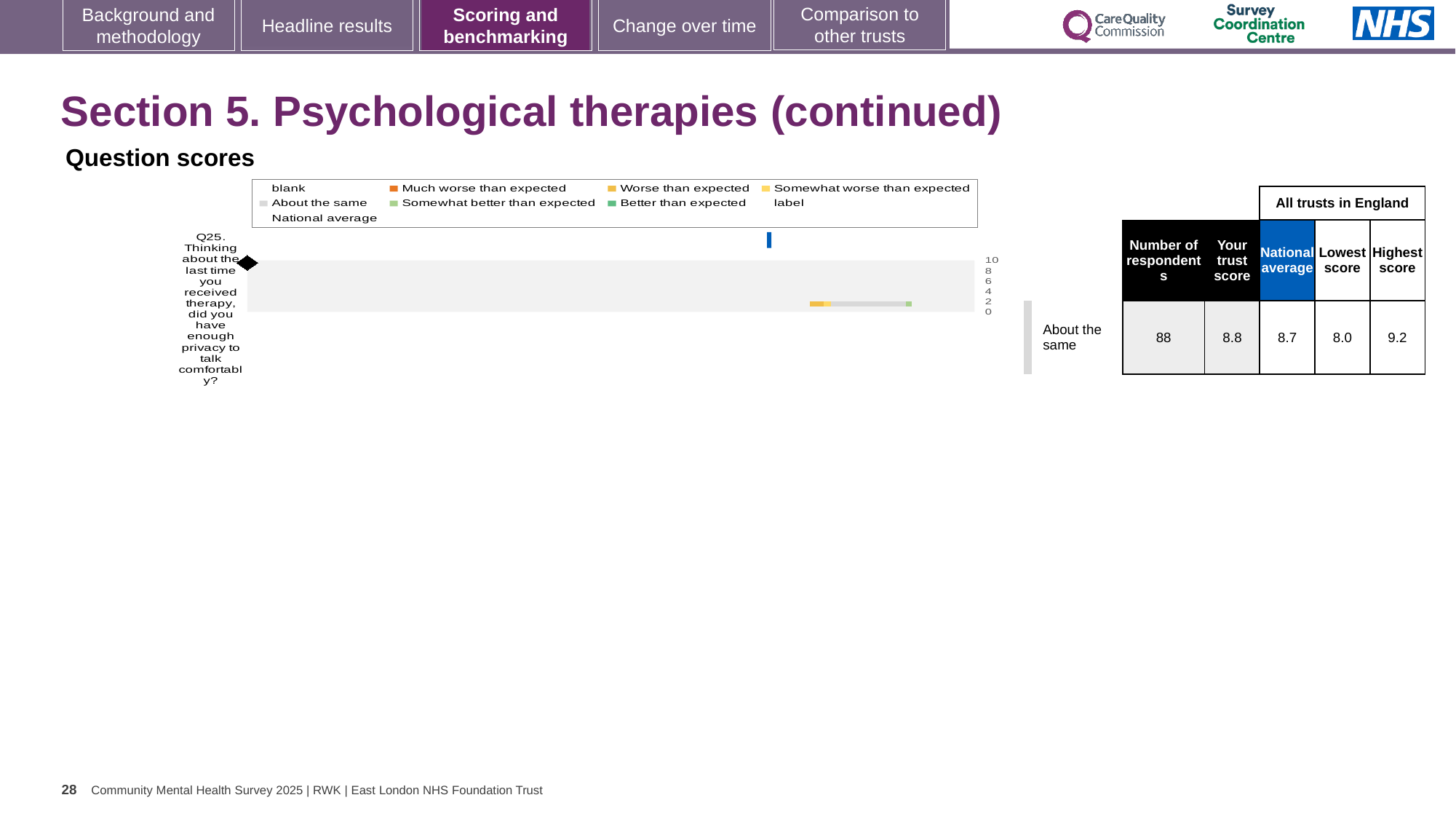
What is the difference between the highest and lowest trust scores for Q25? 1.2 What is the trust's score for Q25 (enough privacy to talk comfortably during therapy)? 8.8 What is the national average score for Q25? 8.7 By how much does the trust's score for Q25 exceed the national average? 0.1 What is the lowest score among all trusts in England for Q25? 8.0 Which benchmark category is the trust's Q25 score placed in? About the same What is the title of the chart on this slide? Question scores What kind of chart is used to show the Q25 question score? bar chart How many respondents answered Q25? 88 How many questions are plotted in the Question scores chart? 1 What is the highest score among all trusts in England for Q25? 9.2 Which is larger for Q25: the trust's score or the national average? the trust's score